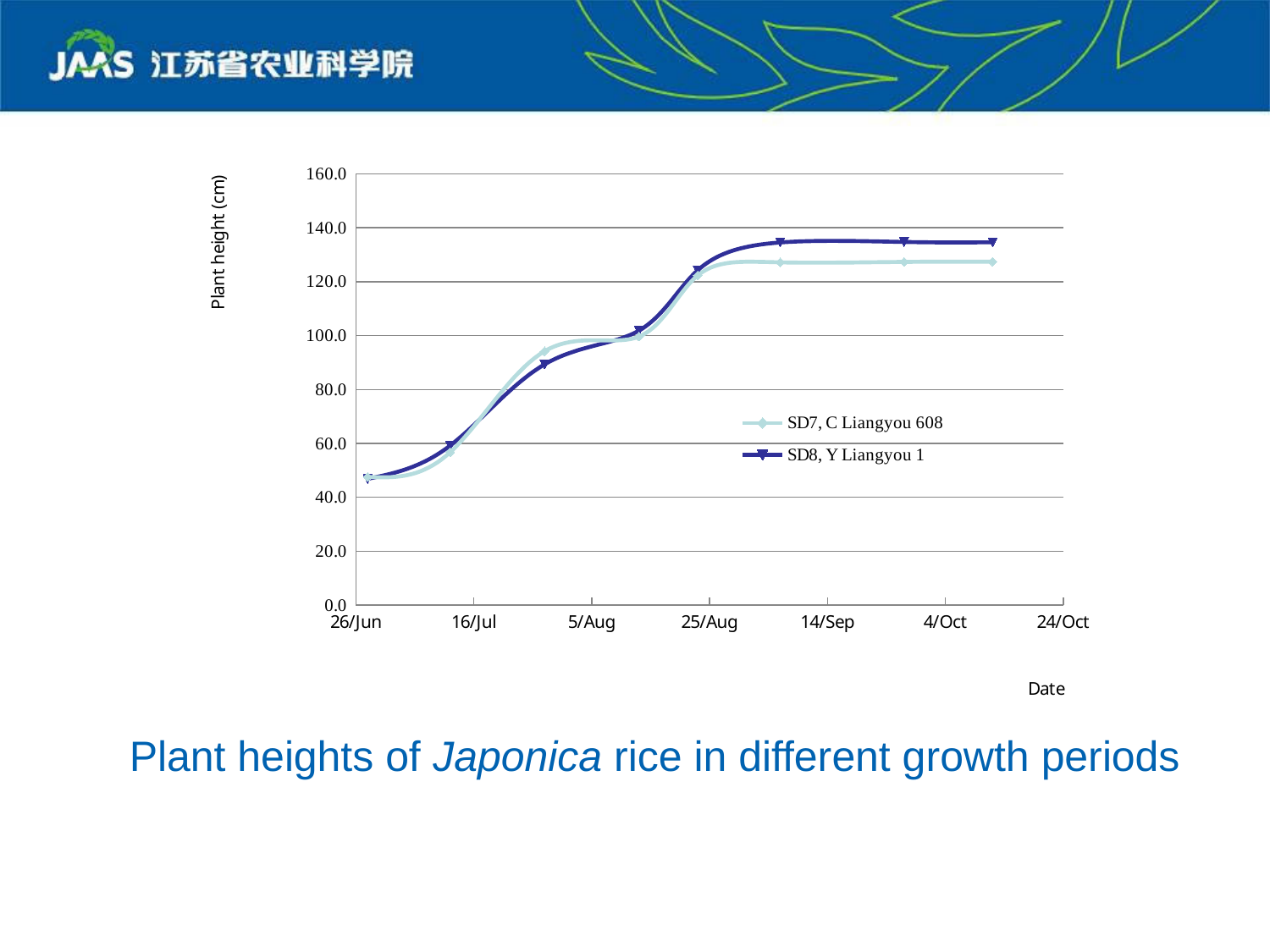
What kind of chart is shown on the slide? line chart Is the final plant height of SD7, C Liangyou 608 greater or less than 120? greater Is the plant height of SD7, C Liangyou 608 on 26/Jun greater or less than 60? less At the last measurement date, which series has the greater plant height, SD7, C Liangyou 608 or SD8, Y Liangyou 1? SD8, Y Liangyou 1 Is the final plant height of SD8, Y Liangyou 1 greater or less than 140? less How many series does the legend list? 2 Do the plant heights rise or fall from 26/Jun to 24/Oct? rise Which series reaches the highest plant height on the chart? SD8, Y Liangyou 1 How many data points are plotted for each series? 8 What is the label of the y axis? Plant height (cm) What are the two series named in the legend? SD7, C Liangyou 608 and SD8, Y Liangyou 1